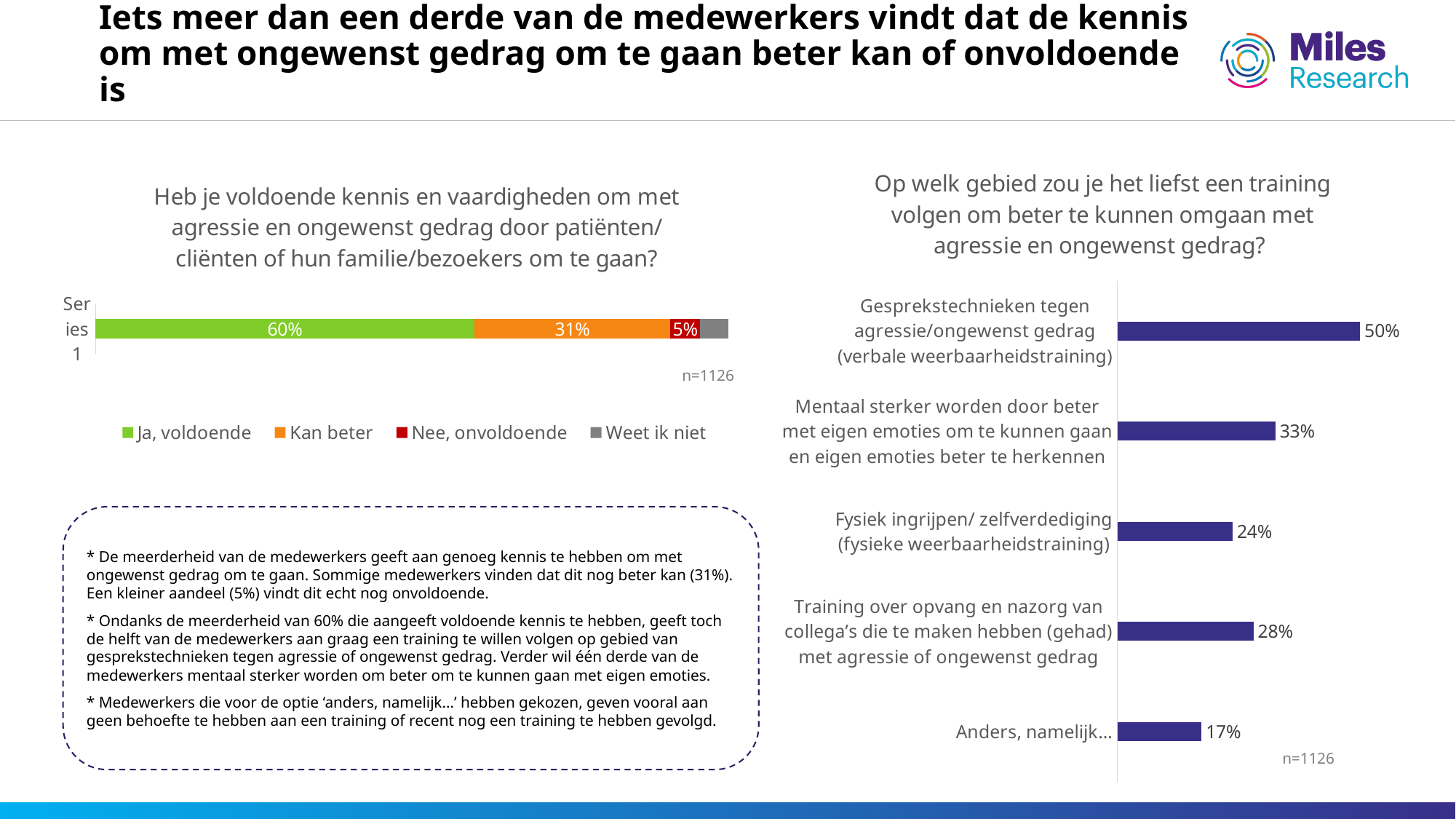
How many series does the legend of the left-hand chart list? 4 In the right-hand chart, which training area has the lowest percentage? Anders, namelijk... In the right-hand chart, what is the value for 'Fysiek ingrijpen/ zelfverdediging (fysieke weerbaarheidstraining)'? 24% In the left-hand chart, what percentage of employees answered 'Kan beter'? 31% What type of chart is the left-hand chart? Stacked bar chart In the right-hand chart, what percentage of employees would prefer training in 'Gesprekstechnieken tegen agressie/ongewenst gedrag (verbale weerbaarheidstraining)'? 50% In the right-hand chart, which is larger: 'Training over opvang en nazorg van collega's...' or 'Fysiek ingrijpen/ zelfverdediging'? Training over opvang en nazorg van collega's... How many training areas (categories) are shown in the right-hand chart? 5 In the left-hand chart, what percentage of employees answered 'Ja, voldoende'? 60% In the right-hand chart, what is the difference between 'Mentaal sterker worden...' (33%) and 'Training over opvang en nazorg van collega's...' (28%)? 5 percentage points In the right-hand chart, what is the value for 'Anders, namelijk...'? 17% In the right-hand chart, which training area has the highest percentage? Gesprekstechnieken tegen agressie/ongewenst gedrag (verbale weerbaarheidstraining)